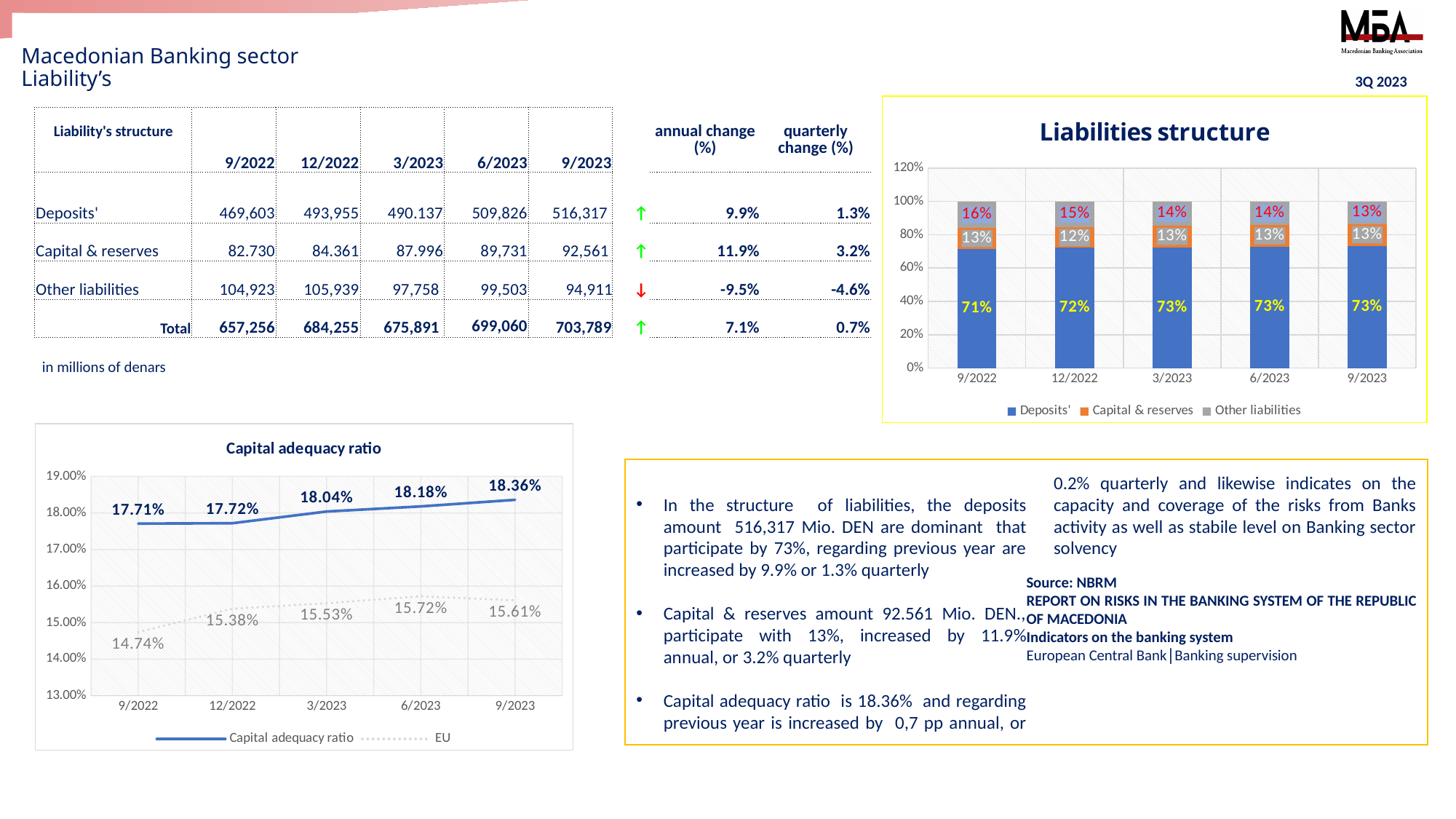
In the Capital adequacy ratio chart, what is the Capital adequacy ratio value for 9/2023? 18.36% In the Capital adequacy ratio chart, how many periods are plotted on the x axis? 5 In the Liabilities structure chart, how many series does the legend list? 3 In the Liabilities structure chart, what kind of chart is shown? Stacked bar chart In the Liabilities structure chart, what share do Capital & reserves have in 12/2022? 12% In the Liabilities structure chart, does the share of Other liabilities rise or fall from 9/2022 to 9/2023? Fall In the Capital adequacy ratio chart, what is the difference between the Capital adequacy ratio and the EU value in 9/2023? 2.75% In the Liabilities structure chart, what share do Other liabilities have in 9/2022? 16% In the Capital adequacy ratio chart, which is larger in 6/2023: the Capital adequacy ratio or the EU value? Capital adequacy ratio In the Liabilities structure chart, what share do Deposits' have in 9/2023? 73% In the Capital adequacy ratio chart, what is the EU value for 9/2022? 14.74% In the Capital adequacy ratio chart, which period has the lowest EU value? 9/2022